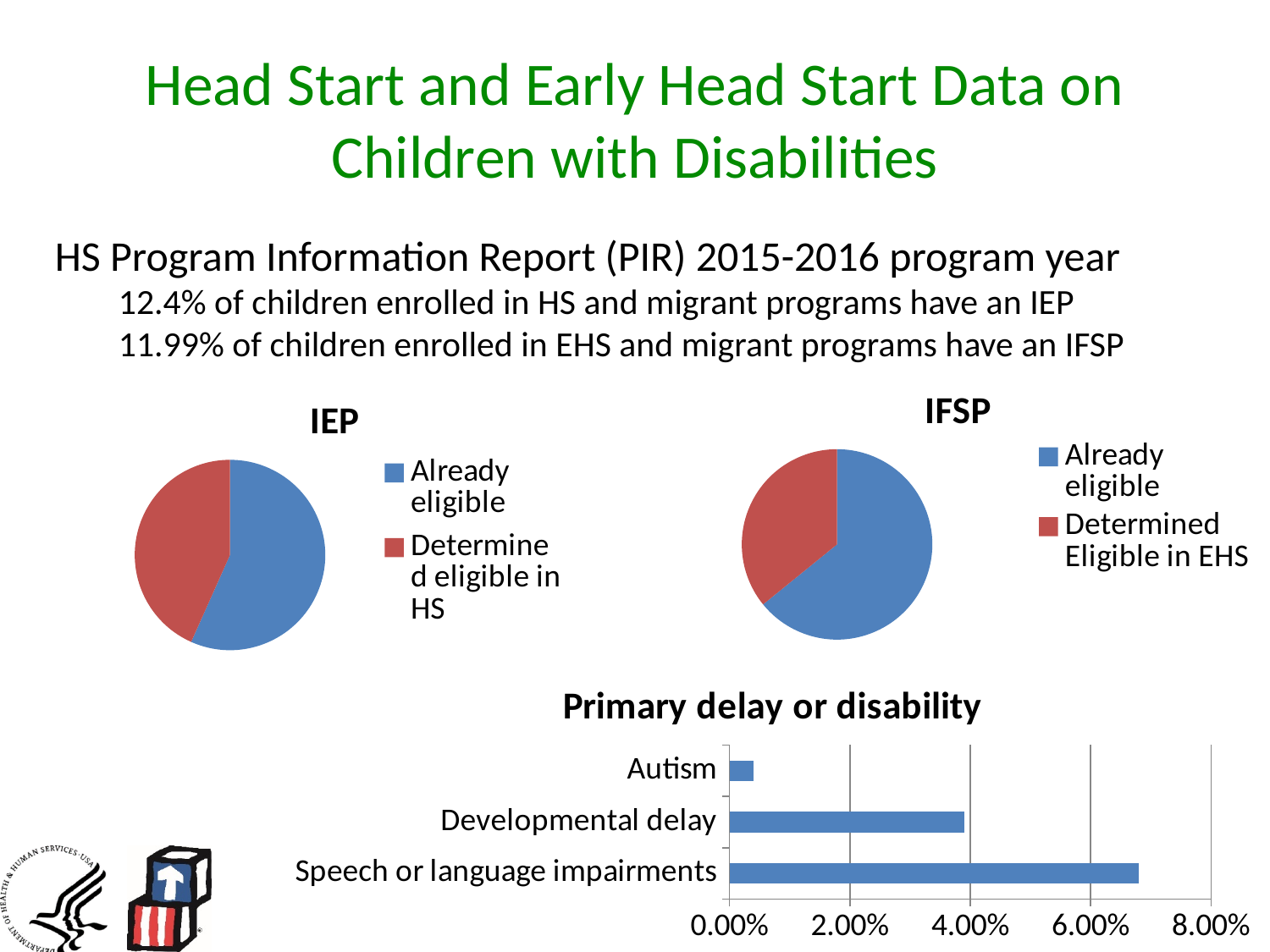
What kind of chart is the IEP chart? Pie chart In the 'Primary delay or disability' chart, which category has the highest value? Speech or language impairments In the 'Primary delay or disability' chart, is the value for Developmental delay greater or less than 2.00%? greater What kind of chart is the 'Primary delay or disability' chart? Bar chart In the 'Primary delay or disability' chart, which category has the lowest value? Autism In the IFSP chart, which slice is larger: Already eligible or Determined Eligible in EHS? Already eligible In the IEP chart, which slice is larger: Already eligible or Determined eligible in HS? Already eligible How many entries does the legend of the IFSP chart list? 2 In the 'Primary delay or disability' chart, which is larger: Developmental delay or Autism? Developmental delay How many categories are shown in the 'Primary delay or disability' chart? 3 In the 'Primary delay or disability' chart, is the value for Autism greater or less than 2.00%? less In the 'Primary delay or disability' chart, is the value for Speech or language impairments greater or less than 6.00%? greater